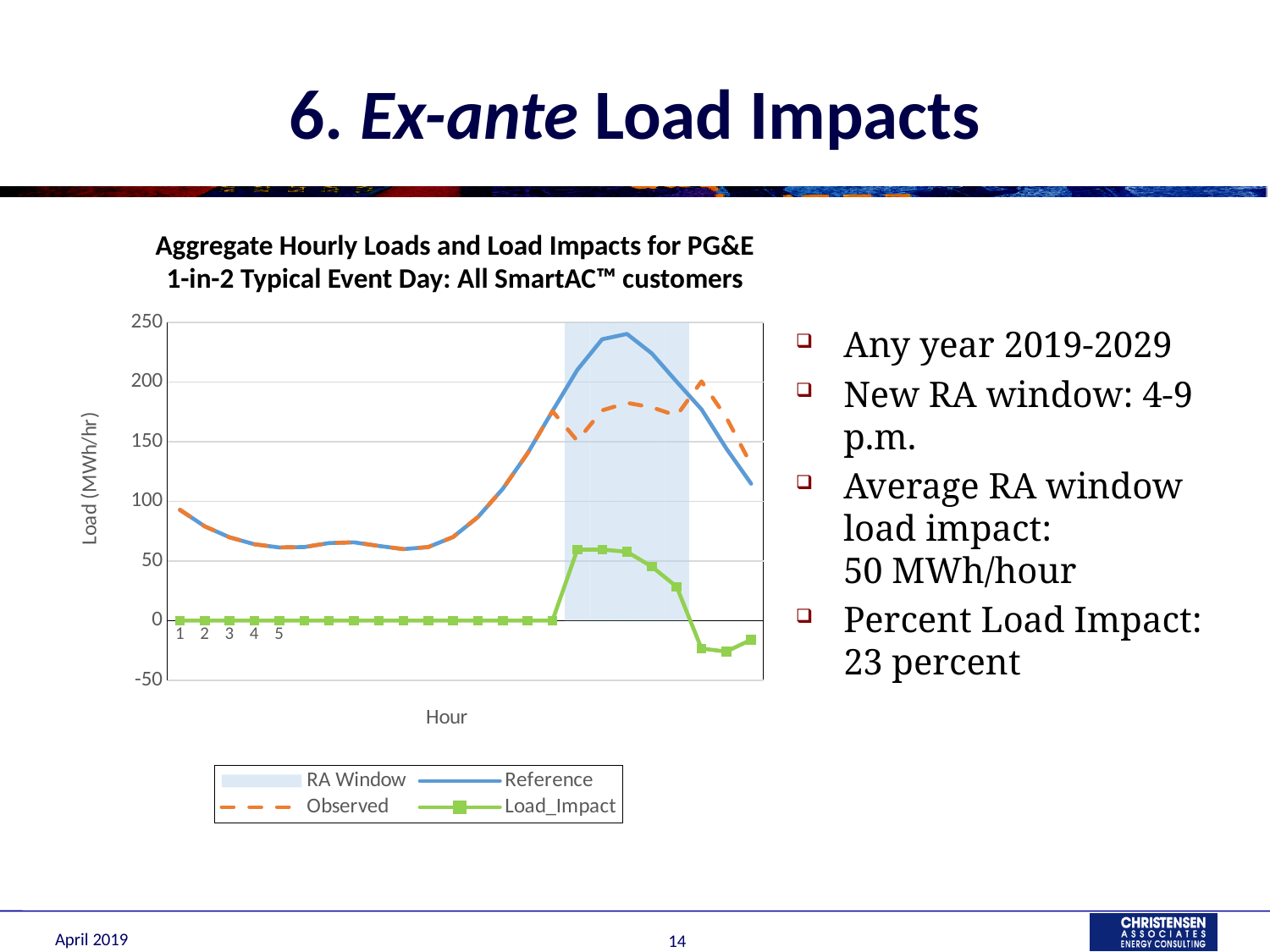
What is the y-axis label of the chart? Load (MWh/hr) Is the Reference value at hour 1 greater or less than 50? greater How many entries does the chart legend list? 4 Is the highest Load_Impact value greater or less than 100? less Is the peak value of the Reference series greater or less than 200? greater Which legend entry is shown as a shaded area rather than a line? RA Window What kind of chart is shown on the slide? line chart What is the Load_Impact value at hour 1? 0 Does the Reference series rise or fall from hour 1 to hour 3? fall Which series reaches the highest value on the chart? Reference